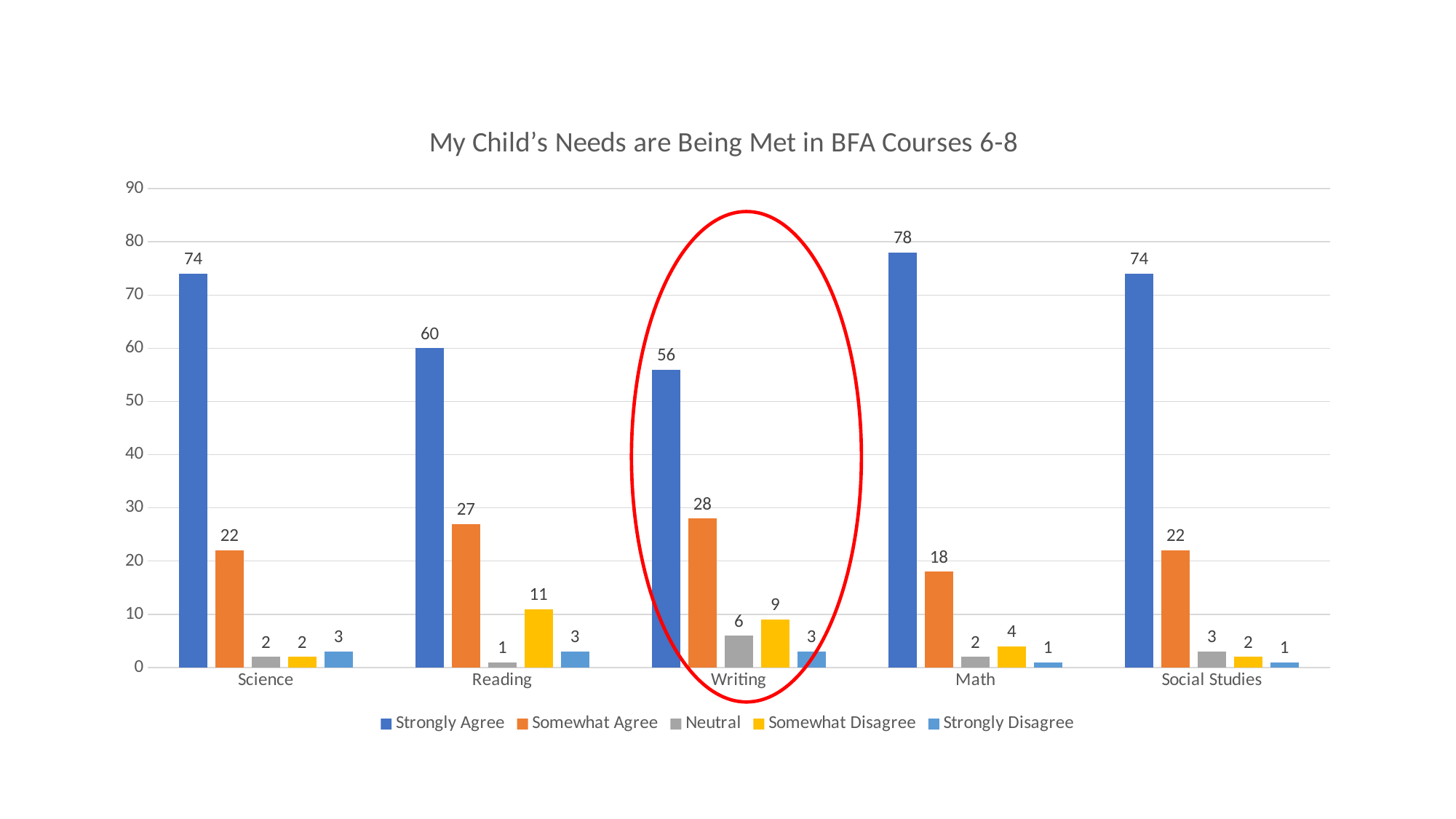
What is the difference between the Strongly Agree values for Math and Writing? 22 What is the Somewhat Agree value for Writing? 28 How many subjects are shown on the x axis? 5 How many series does the legend list? 5 Which subject has the lowest Strongly Agree value? Writing Which is larger, the Somewhat Agree value for Reading or for Math? Reading What is the Somewhat Disagree value for Reading? 11 Which subject is circled in red on the chart? Writing Which subject has the highest Strongly Agree value? Math What is the Neutral value for Social Studies? 3 What kind of chart is shown? Bar chart What is the Strongly Agree value for Math? 78